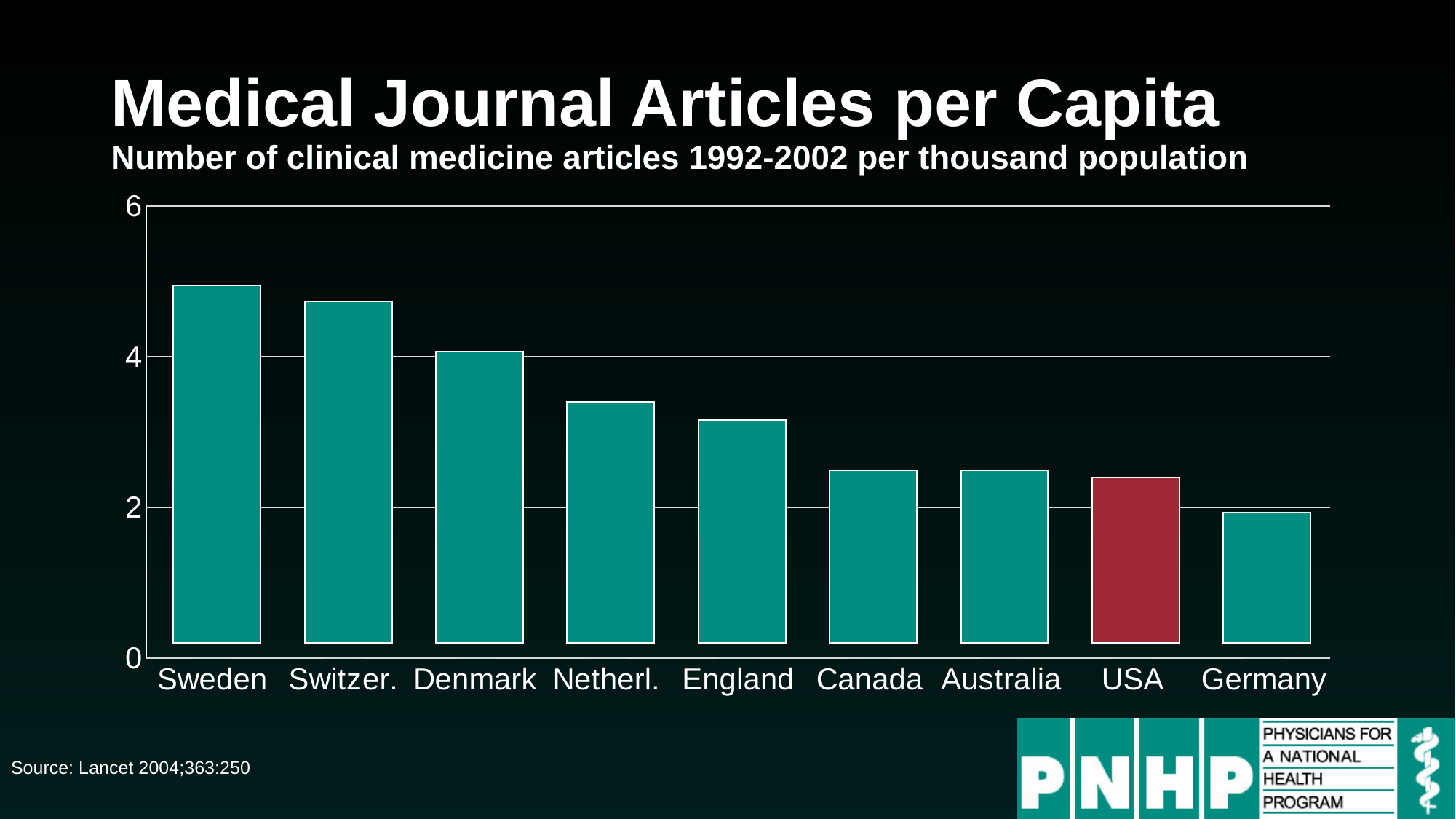
Is the value for Netherl. greater or less than 4? less Which country's bar is shown in a different colour (red) from the others? USA Is the value for Sweden greater or less than 4? greater Which has a higher value, Netherl. or England? Netherl. Is the value for USA greater or less than 2? greater Which has a higher value, Switzer. or Canada? Switzer. Do the values rise or fall moving from left to right along the x axis? fall How many countries are shown on the x axis of the chart? 9 Which country has the highest number of clinical medicine articles per thousand population? Sweden Which country has the lowest number of clinical medicine articles per thousand population? Germany What kind of chart is shown on the slide? bar chart